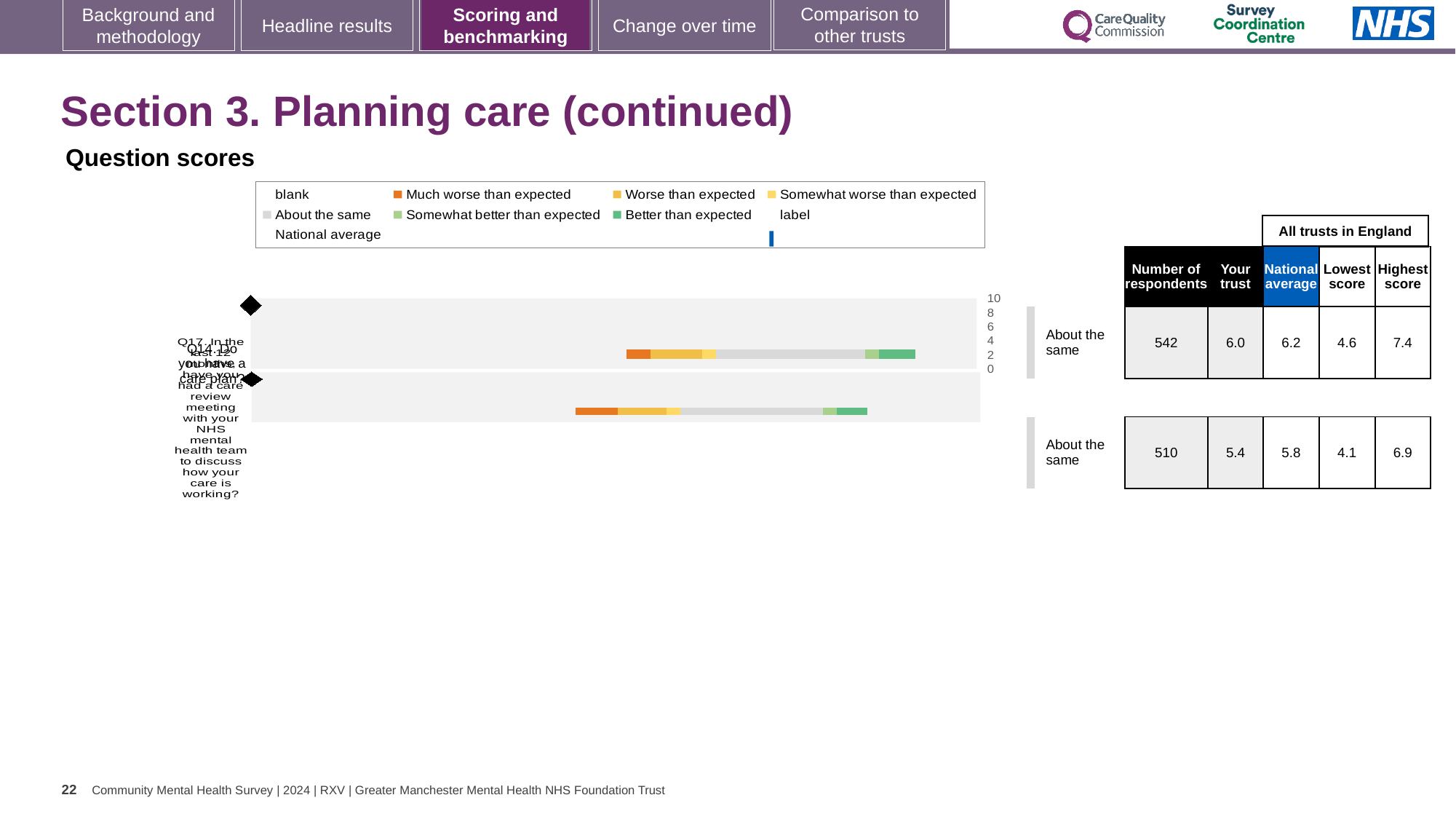
What is the 'Your trust' score for the first (top) question row, Q14? 6.0 What is the national average for the first (top) question row, Q14? 6.2 What is the number of respondents for the first (top) question row, Q14? 542 What kind of chart is used to show the question scores? Bar chart What benchmark category is shown next to both question rows? About the same Which question row has the higher 'Your trust' score, the top row (Q14) or the bottom row (Q17)? Q14 (top row) What is the lowest score among all trusts in England for the first (top) question row, Q14? 4.6 What is the number of respondents for the second (bottom) question row, Q17? 510 What is the 'Your trust' score for the second (bottom) question row, Q17? 5.4 What is the highest score among all trusts in England for the second (bottom) question row, Q17? 6.9 What is the difference between the national average and the 'Your trust' score for the second (bottom) question row, Q17? 0.4 How many question rows (bars) are plotted in the chart? 2